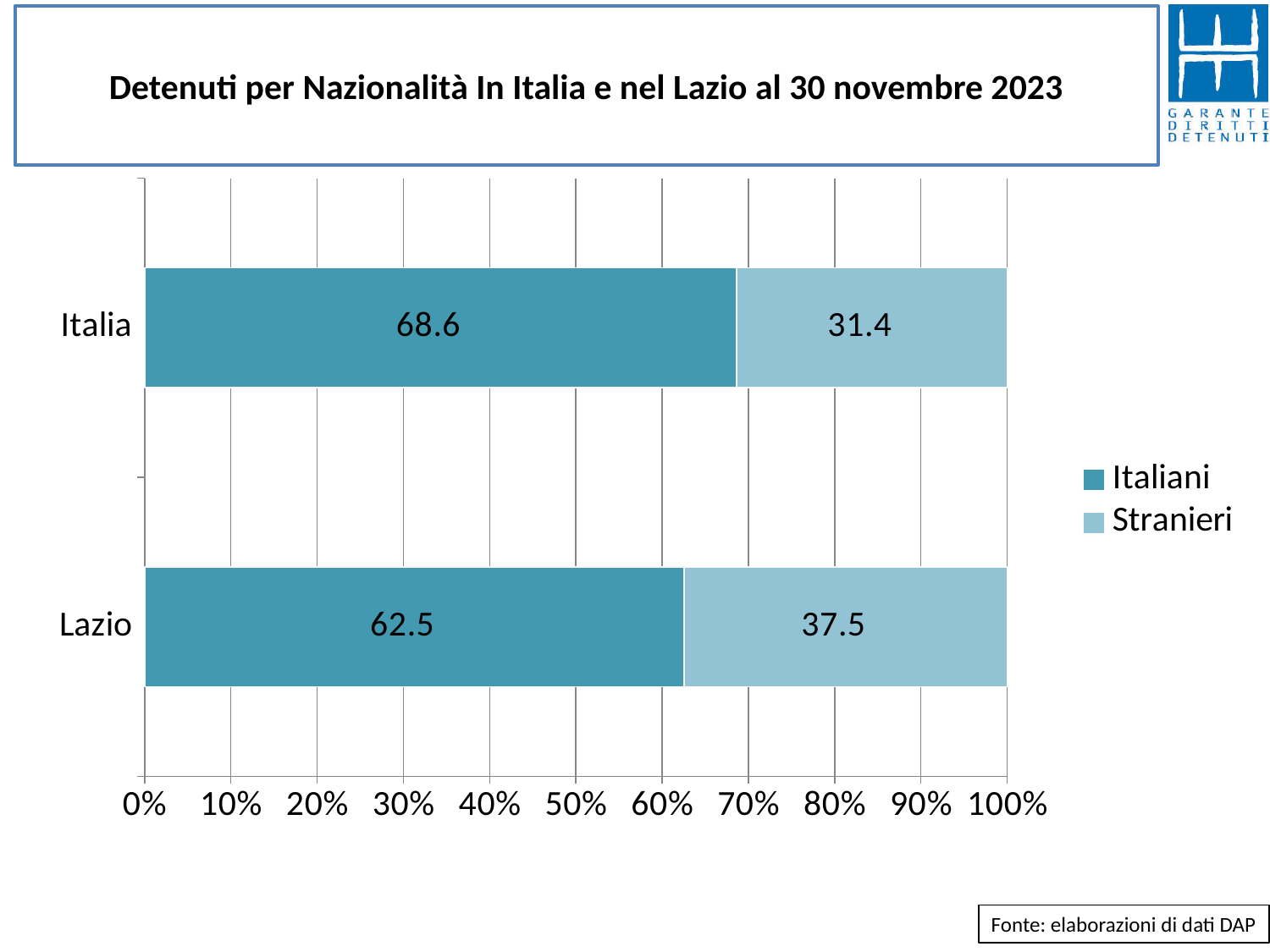
How many series does the legend list? 2 What is the difference between the Stranieri values for Lazio and Italia? 6.1 Which category has the lower value for Stranieri? Italia What is the difference between the Italiani values for Italia and Lazio? 6.1 What kind of chart is shown on the slide? Stacked bar chart What is the title of the chart? Detenuti per Nazionalità In Italia e nel Lazio al 30 novembre 2023 Which category has the higher value for Italiani, Italia or Lazio? Italia What is the value for Stranieri in Lazio? 37.5 What is the value for Stranieri in Italia? 31.4 What is the value for Italiani in Italia? 68.6 What is the value for Italiani in Lazio? 62.5 How many categories are shown on the chart? 2